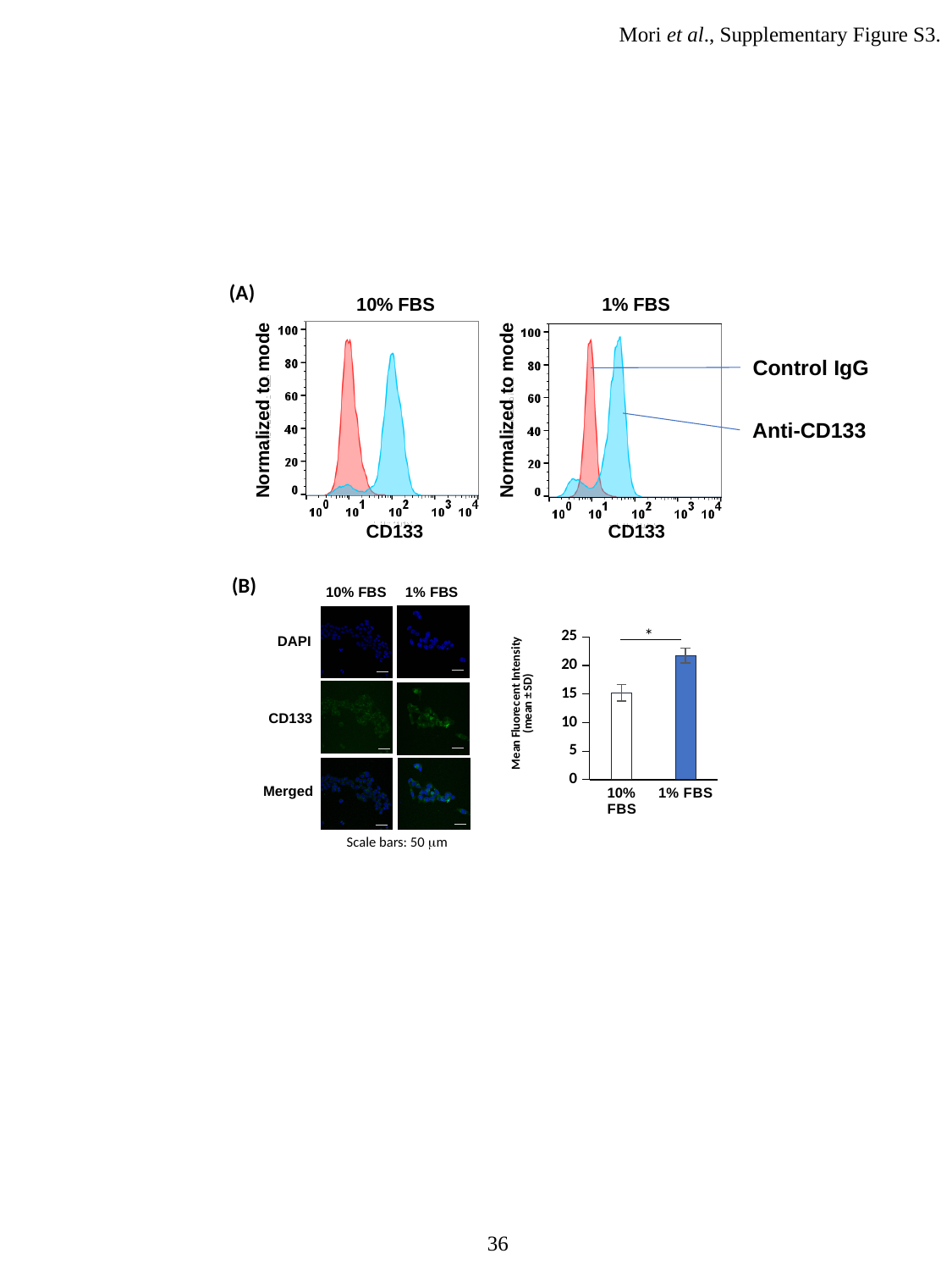
How many bars are shown in the bar chart in panel (B)? 2 In the bar chart in panel (B), is the bar for 10% FBS or the bar for 1% FBS taller? 1% FBS In the bar chart in panel (B), is the Mean Fluorescent Intensity for 1% FBS greater or less than 25? less What kind of chart is shown on the right side of panel (B)? bar chart In the bar chart in panel (B), which condition has the higher Mean Fluorescent Intensity? 1% FBS In the bar chart in panel (B), is the Mean Fluorescent Intensity for 10% FBS greater or less than 10? greater In the flow cytometry histograms in panel (A), what are the two labelled series? Control IgG and Anti-CD133 In the bar chart in panel (B), is the Mean Fluorescent Intensity for 1% FBS greater or less than 20? greater What is the highest value shown on the y axis of the bar chart in panel (B)? 25 In the bar chart in panel (B), which condition has the lower Mean Fluorescent Intensity? 10% FBS What is the x-axis label of the histograms in panel (A)? CD133